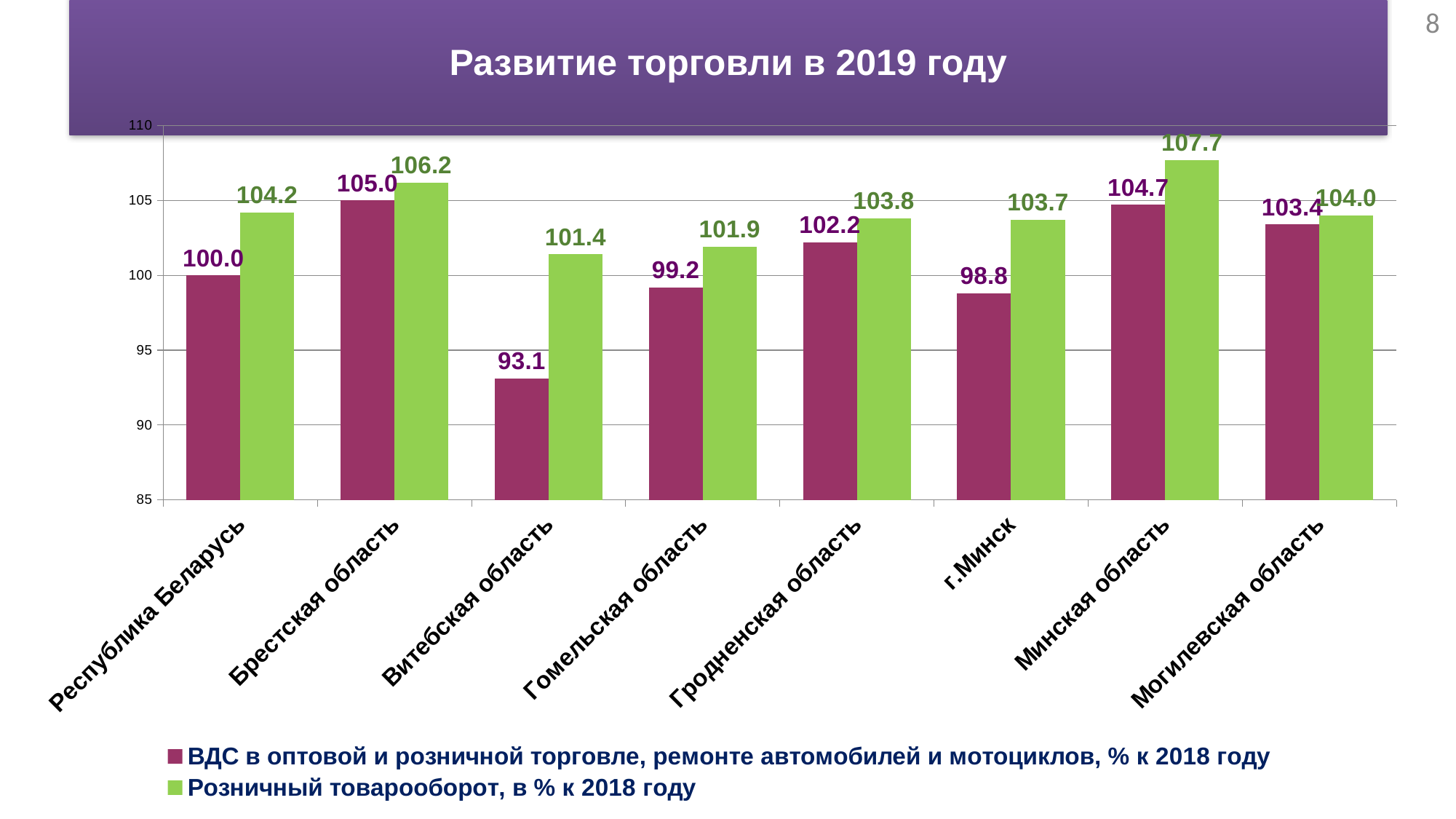
What is the value of 'ВДС в оптовой и розничной торговле, ремонте автомобилей и мотоциклов, % к 2018 году' for г.Минск? 98.8 Which category has the lowest value for 'ВДС в оптовой и розничной торговле, ремонте автомобилей и мотоциклов, % к 2018 году'? Витебская область Is the value of 'ВДС в оптовой и розничной торговле, ремонте автомобилей и мотоциклов, % к 2018 году' for Гомельская область greater or less than 100? less What is the difference between 'Розничный товарооборот, в % к 2018 году' and 'ВДС в оптовой и розничной торговле, ремонте автомобилей и мотоциклов, % к 2018 году' for Витебская область? 8.3 How many categories are shown on the x axis? 8 Which category has the highest value for 'Розничный товарооборот, в % к 2018 году'? Минская область What is the value of 'ВДС в оптовой и розничной торговле, ремонте автомобилей и мотоциклов, % к 2018 году' for Витебская область? 93.1 What type of chart is shown on the slide? bar chart How many series does the legend list? 2 What is the value of 'Розничный товарооборот, в % к 2018 году' for Минская область? 107.7 Which is larger for Брестская область: 'ВДС в оптовой и розничной торговле, ремонте автомобилей и мотоциклов, % к 2018 году' or 'Розничный товарооборот, в % к 2018 году'? Розничный товарооборот, в % к 2018 году What is the title of the chart? Развитие торговли в 2019 году